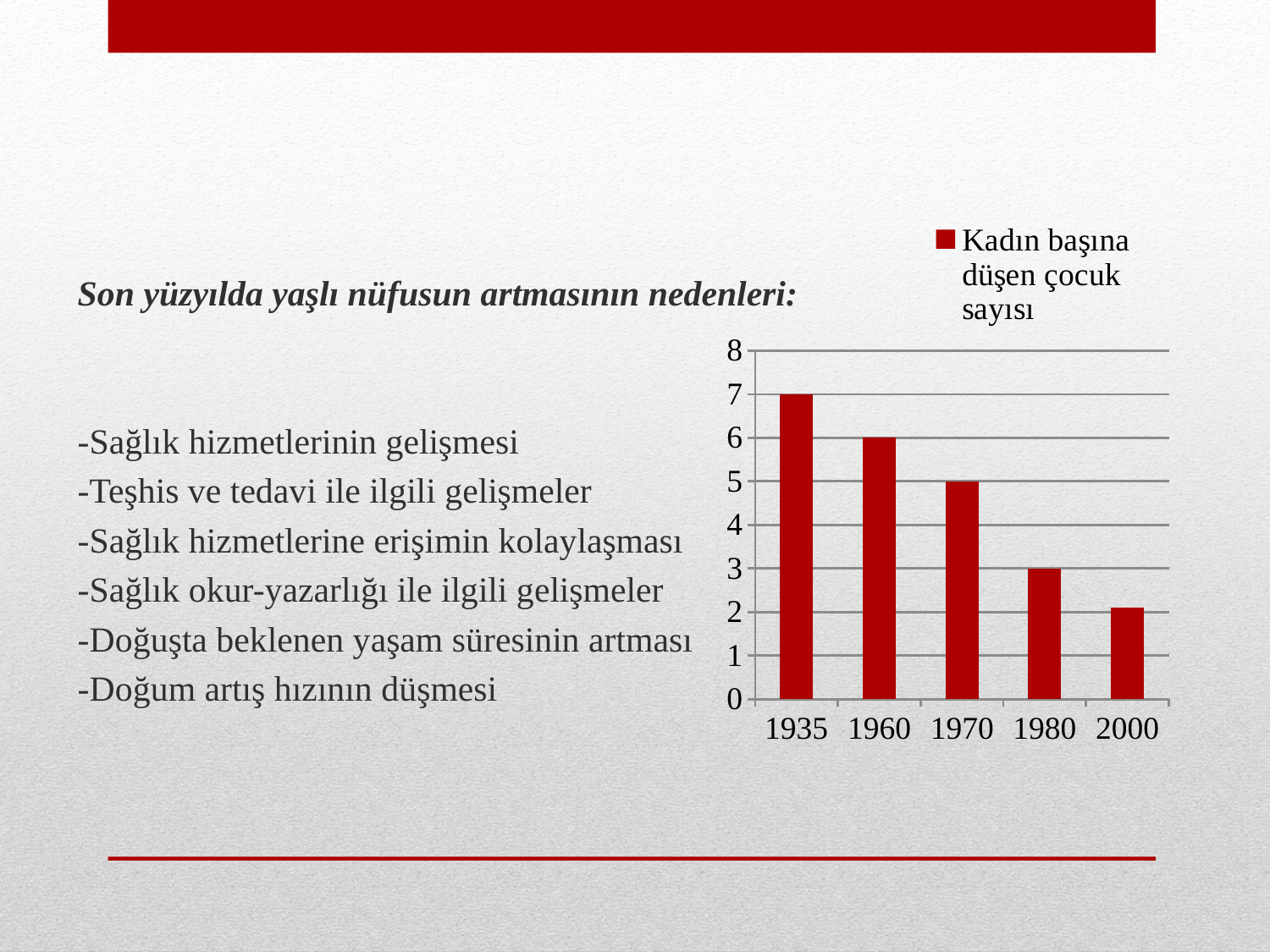
What is the value for 1980 in the chart? 3 What is the value for 1970 in the chart? 5 Is the value for 2000 greater or less than 3? less Which year has the lowest value in the chart? 2000 Which year has the highest value in the chart? 1935 What kind of chart is shown on the slide? bar chart What is the value for 1935 in the chart? 7 What is the value for 1960 in the chart? 6 What is the difference between the values for 1935 and 1980? 4 How many series does the chart legend list? 1 What is the name of the series shown in the chart legend? Kadın başına düşen çocuk sayısı How many years (categories) are shown on the x axis of the chart? 5